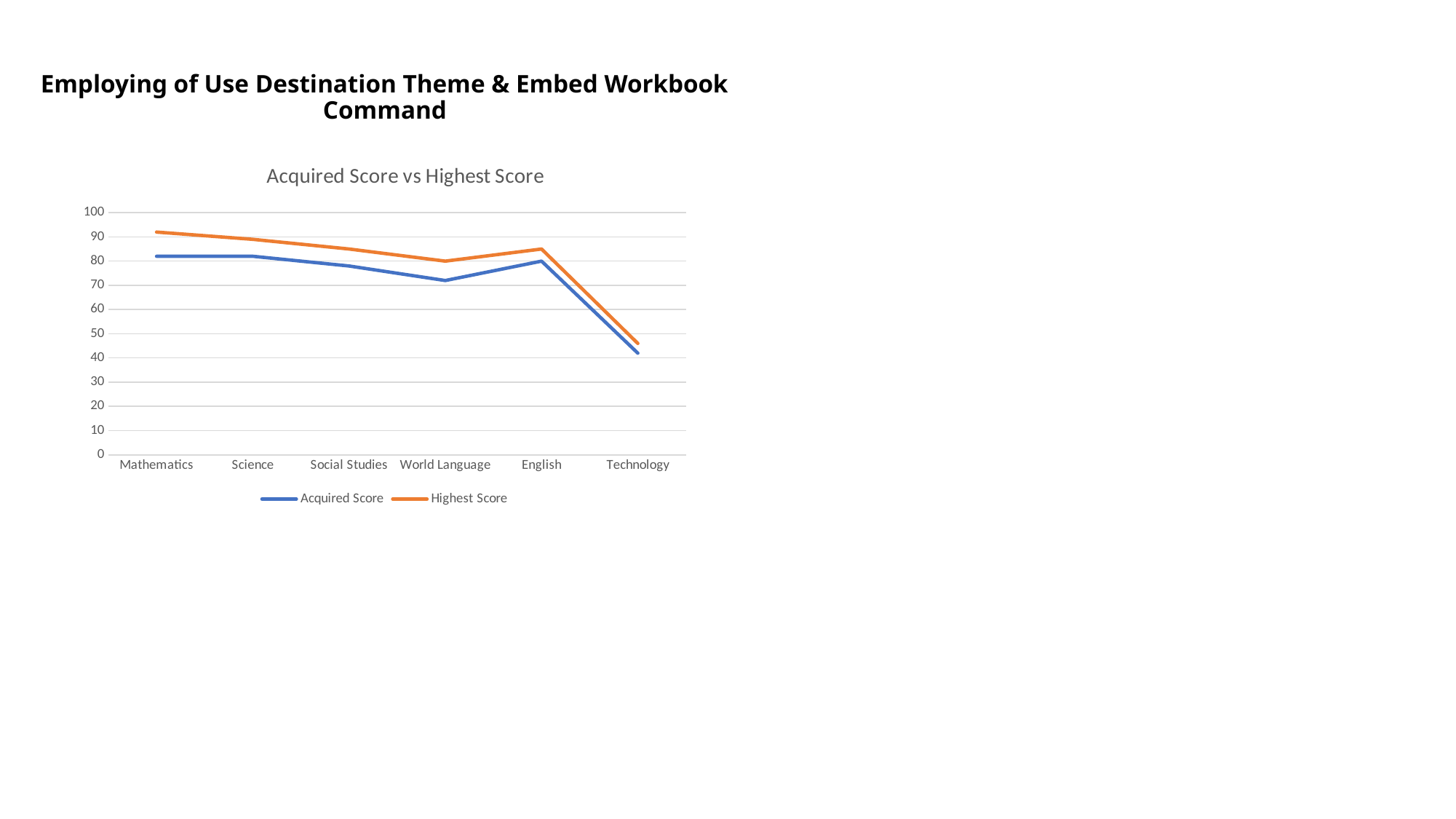
Which category has the highest Highest Score? Mathematics How many categories are plotted along the x axis? 6 Is the Acquired Score for Technology greater or less than 50? less What kind of chart is shown on the slide? line chart Is the Highest Score for Mathematics greater or less than 90? greater Which category has the lowest Acquired Score? Technology What is the title of the chart? Acquired Score vs Highest Score How many series does the legend list? 2 Which category has the lowest Highest Score? Technology Does the Acquired Score rise or fall from English to Technology? falls Is the Acquired Score for World Language greater or less than 80? less For Mathematics, which is larger: the Acquired Score or the Highest Score? Highest Score